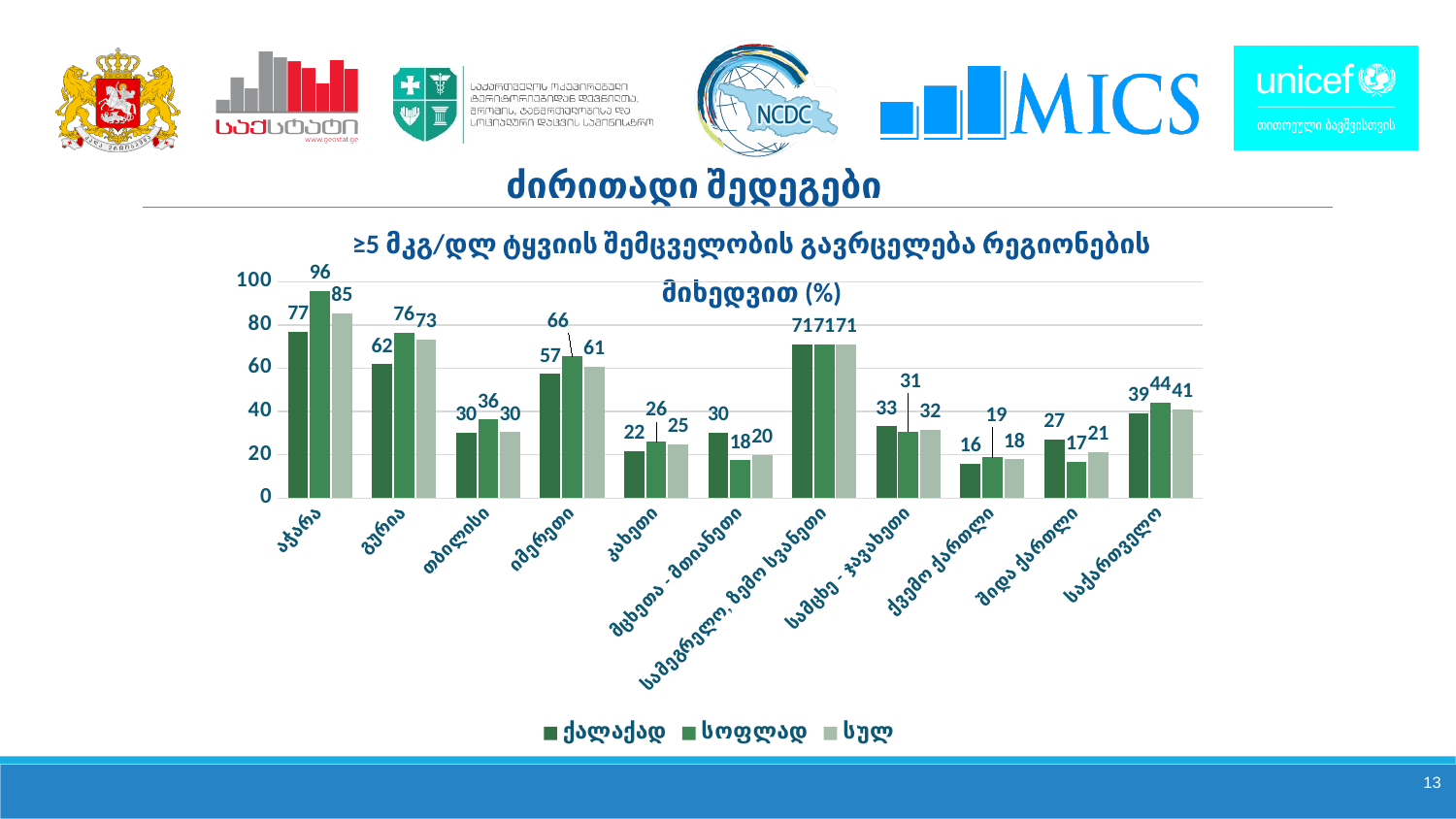
How many series does the legend list? 3 What is the difference between the სოფლად and ქალაქად values in გურია? 14 Which region has the lowest ქალაქად value? ქვემო ქართლი What is the სულ value for საქართველო? 41 Which region has the highest სოფლად value? აჭარა What is the value for სოფლად in აჭარა? 96 Is the სულ value for სამეგრელო, ზემო სვანეთი greater or less than 60? greater What are the three legend entries of the chart? ქალაქად, სოფლად, სულ What type of chart is shown on the slide? bar chart Which is larger in შიდა ქართლი, the ქალაქად value or the სოფლად value? ქალაქად What is the value for ქალაქად in იმერეთი? 57 How many regions (categories) are shown on the x axis? 11